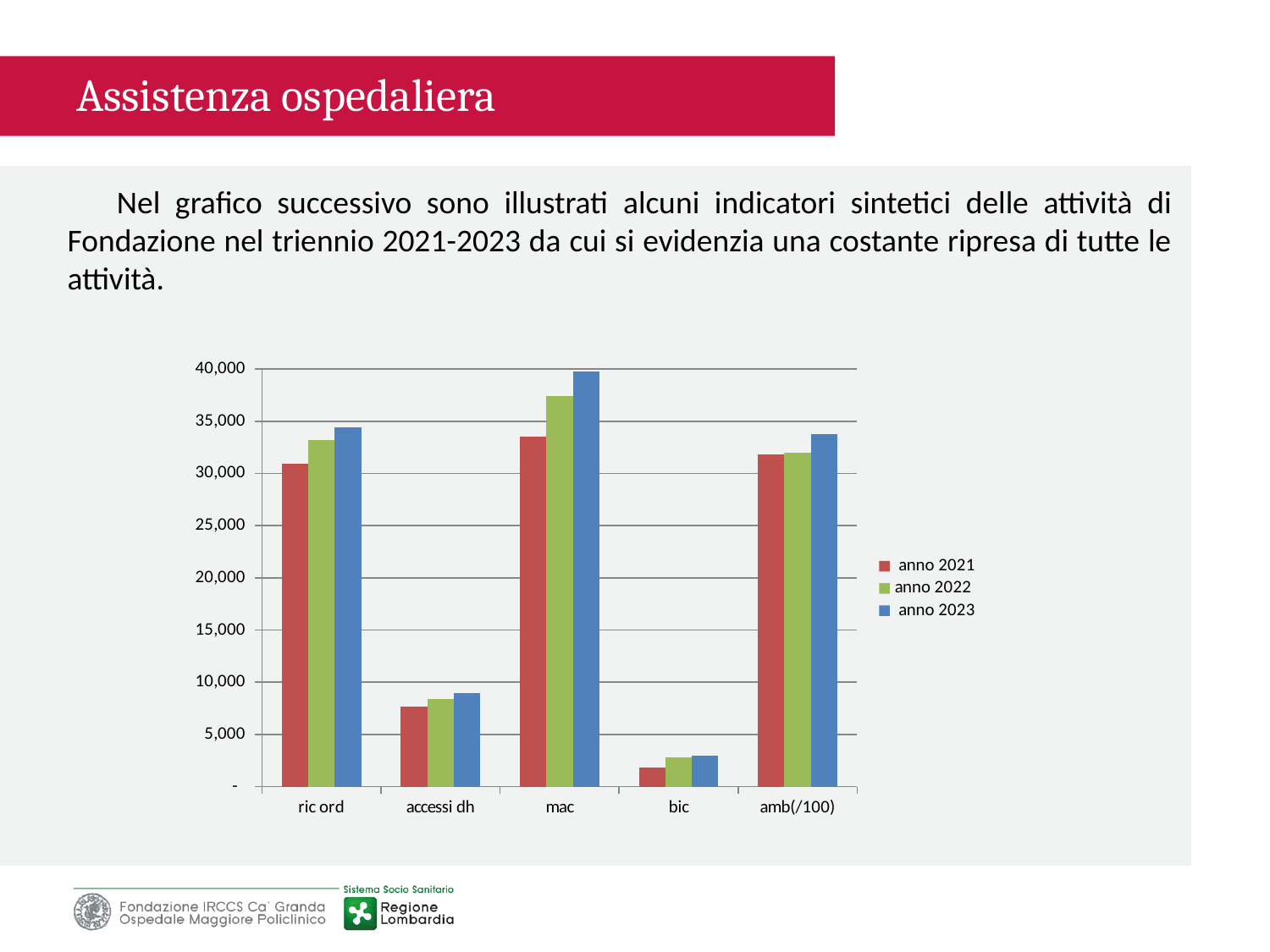
What are the three entries listed in the legend? anno 2021, anno 2022, anno 2023 How many categories are shown on the x axis? 5 Which category has the highest anno 2023 bar? mac How many series does the legend list? 3 Which is larger for anno 2022: mac or ric ord? mac Is the anno 2023 value for mac greater or less than 35,000? greater Is the anno 2021 value for accessi dh greater or less than 10,000? less For the category mac, do the values rise or fall from anno 2021 to anno 2023? rise What colour are the anno 2021 bars? red Is the anno 2023 value for bic greater or less than 5,000? less Which category has the lowest anno 2021 bar? bic What kind of chart is shown on the slide? bar chart